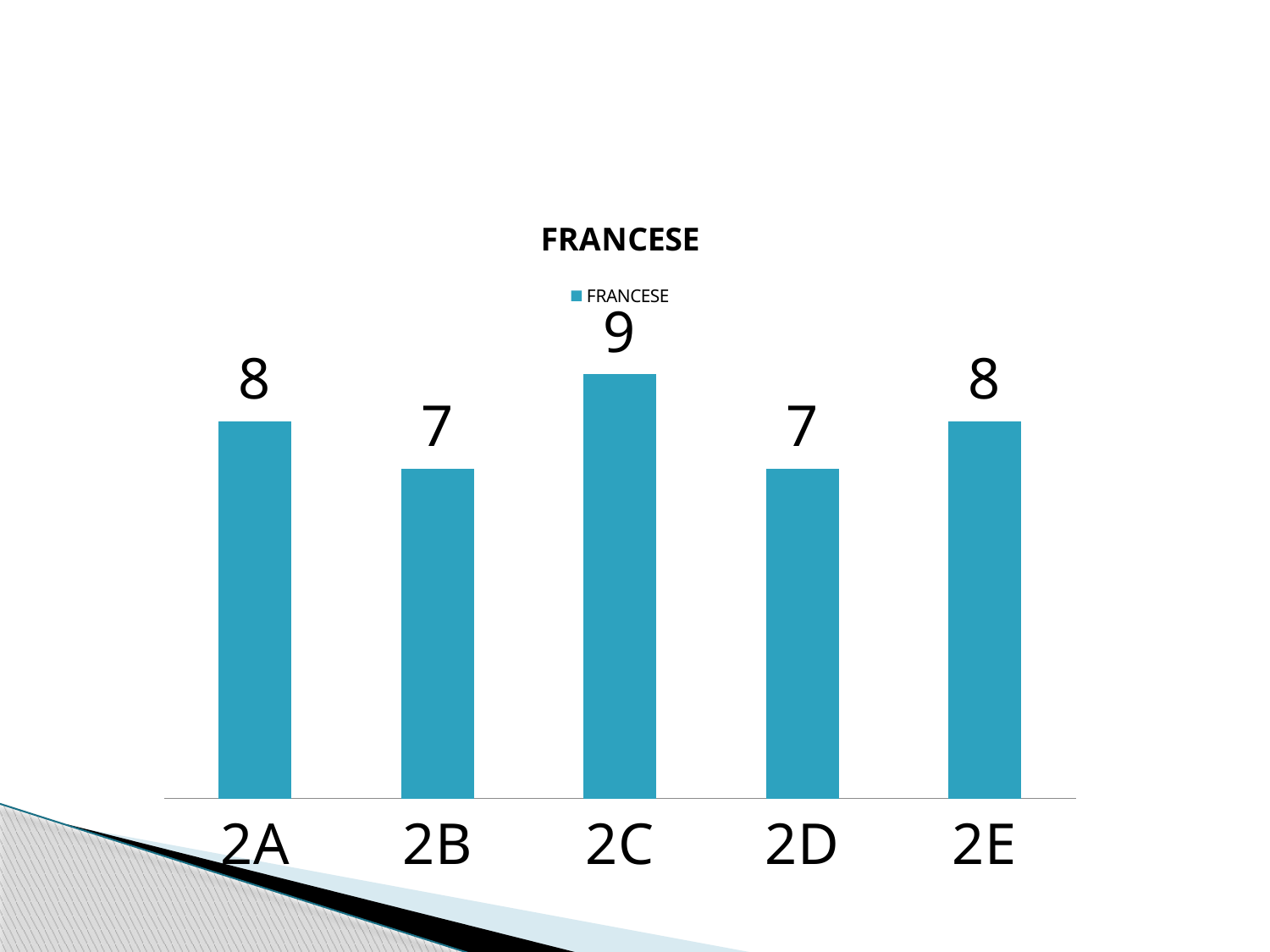
What is the title of the chart? FRANCESE What kind of chart is shown? bar chart What is the value for 2D? 7 Which category has the highest value? 2C Which is larger, the value for 2A or the value for 2B? 2A How many categories are shown on the x axis? 5 What series name appears in the legend? FRANCESE What is the difference between the values for 2E and 2D? 1 How many series does the legend list? 1 What is the value for 2C? 9 What is the value for 2A? 8 What is the difference between the values for 2C and 2B? 2